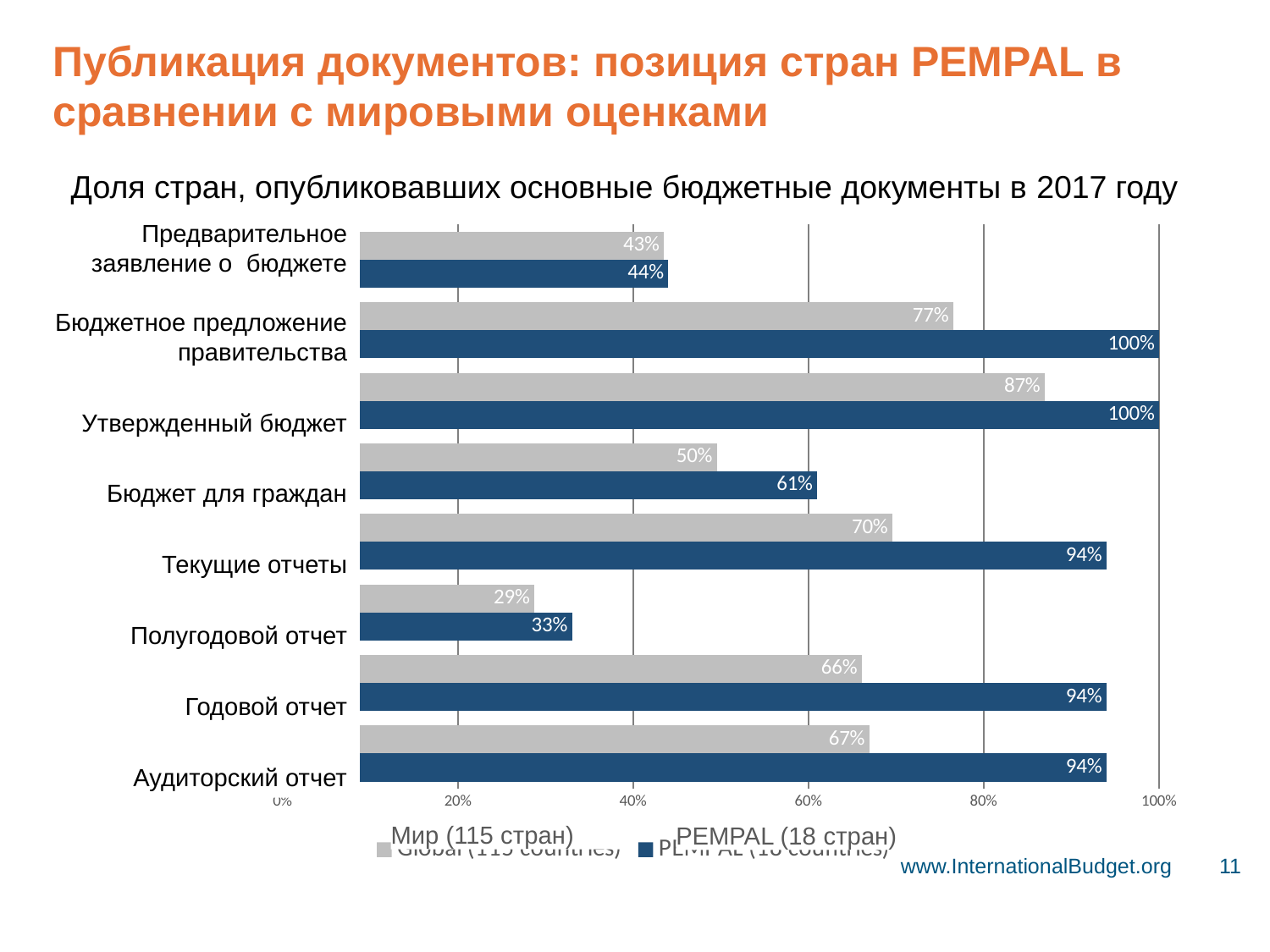
What is the difference between the PEMPAL (18 стран) and Мир (115 стран) values for Текущие отчеты? 24% What is the value for Мир (115 стран) for Полугодовой отчет? 29% Which is larger for Годовой отчет: the value for Мир (115 стран) or for PEMPAL (18 стран)? PEMPAL (18 стран) What is the difference between the PEMPAL (18 стран) and Мир (115 стран) values for Бюджетное предложение правительства? 23% How many categories are shown on the chart? 8 Which colour represents the PEMPAL (18 стран) series? Blue What kind of chart is shown on the slide? Bar chart Which category has the highest value for Мир (115 стран)? Утвержденный бюджет What is the value for Мир (115 стран) for Утвержденный бюджет? 87% How many series does the legend list? 2 Which category has the lowest value for PEMPAL (18 стран)? Полугодовой отчет What is the value for PEMPAL (18 стран) for Бюджет для граждан? 61%